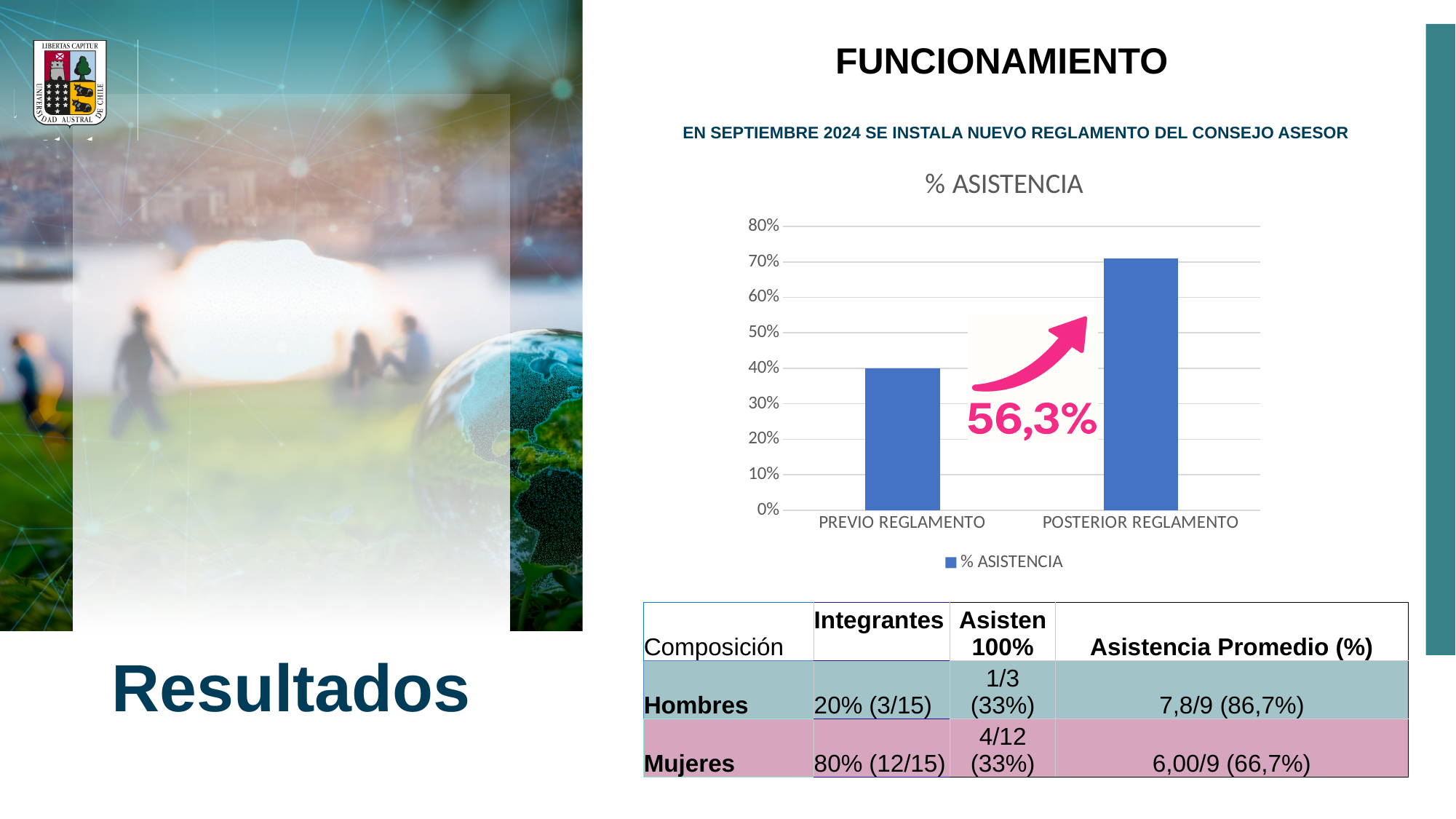
Is the value for POSTERIOR REGLAMENTO greater or less than 80%? less Which category has the lower value in the "% ASISTENCIA" chart? PREVIO REGLAMENTO What is the legend entry of the "% ASISTENCIA" chart? % ASISTENCIA Is the value for PREVIO REGLAMENTO greater or less than 50%? less Do the values rise or fall from PREVIO REGLAMENTO to POSTERIOR REGLAMENTO? rise What percentage is printed next to the pink arrow between the two bars? 56,3% Is the value for POSTERIOR REGLAMENTO greater or less than 60%? greater Which category has the higher value in the "% ASISTENCIA" chart? POSTERIOR REGLAMENTO What type of chart is shown under the title "% ASISTENCIA"? bar chart How many series does the legend of the "% ASISTENCIA" chart list? 1 How many categories are shown on the x axis of the "% ASISTENCIA" chart? 2